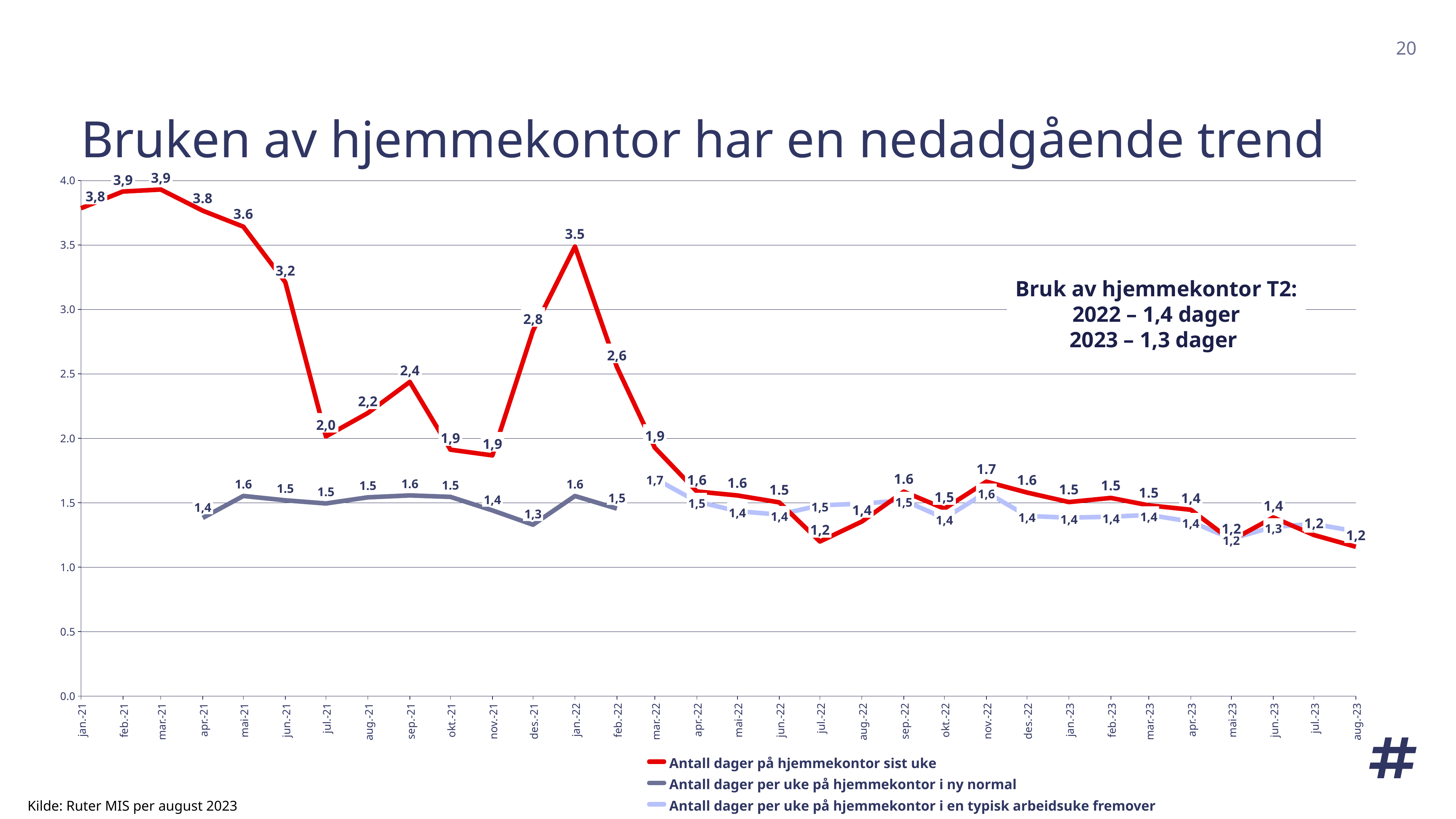
How many months are shown on the x axis? 32 What is the value of 'Antall dager per uke på hjemmekontor i en typisk arbeidsuke fremover' for mar.-22? 1,7 What is the value of 'Antall dager på hjemmekontor sist uke' for jul.-22? 1,2 How many series does the legend list? 3 Which month has the higher value for 'Antall dager på hjemmekontor sist uke': des.-21 or feb.-22? des.-21 In which month is 'Antall dager per uke på hjemmekontor i en typisk arbeidsuke fremover' highest? mar.-22 Is the value for 'Antall dager på hjemmekontor sist uke' in jun.-21 greater or less than 3.0? greater What is the value of 'Antall dager på hjemmekontor sist uke' for jan.-22? 3.5 What kind of chart is shown on the slide? line chart In which month is 'Antall dager per uke på hjemmekontor i ny normal' lowest? des.-21 Does 'Antall dager på hjemmekontor sist uke' rise or fall overall from jan.-21 to aug.-23? fall What is the difference between the 'Antall dager på hjemmekontor sist uke' values for jan.-21 and aug.-23? 2,6